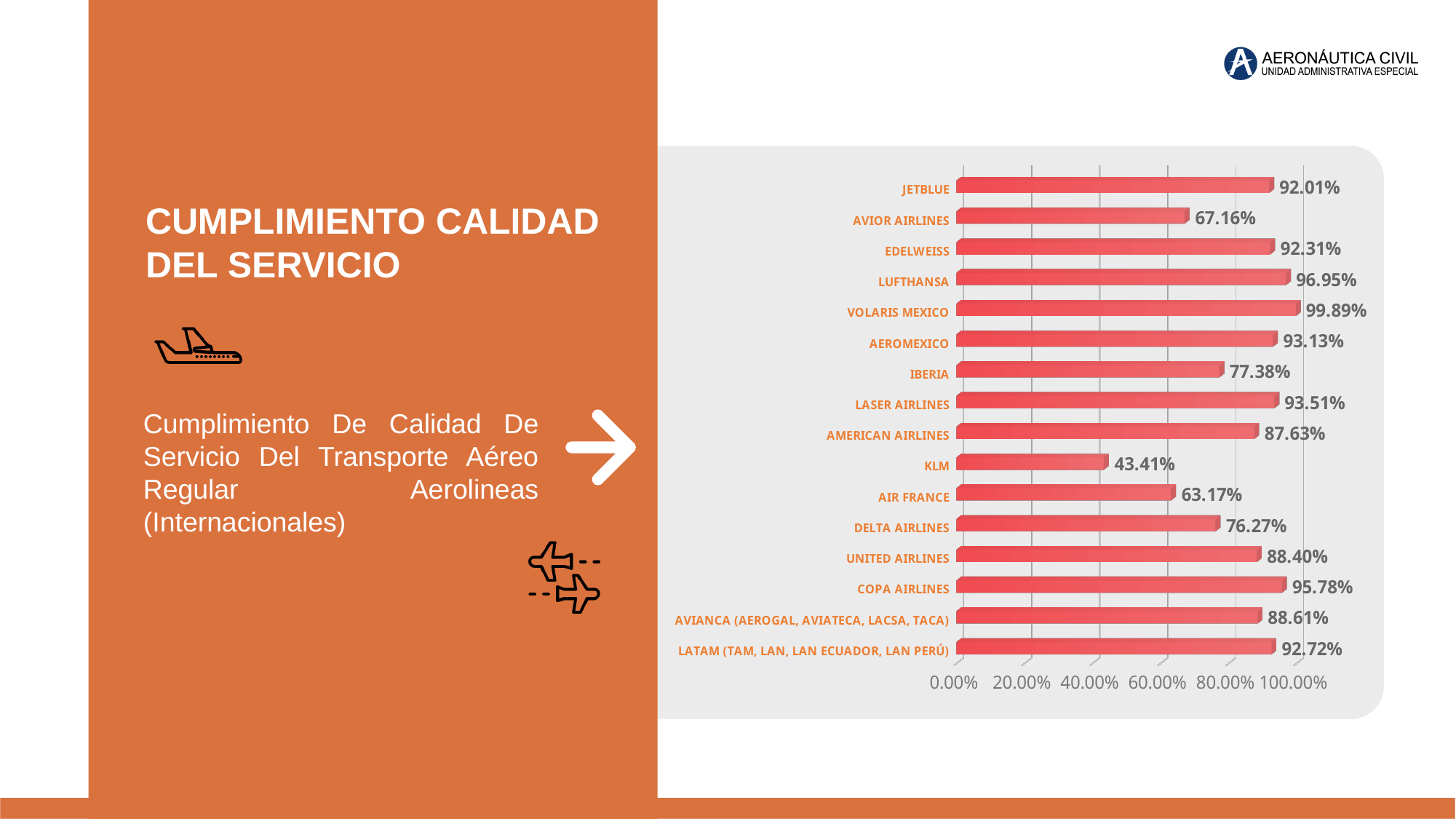
Which airline has the highest value? VOLARIS MEXICO Which has a larger value, AVIOR AIRLINES or AIR FRANCE? AVIOR AIRLINES What is the value for LATAM (TAM, LAN, LAN ECUADOR, LAN PERÚ)? 92.72% What is the value for AMERICAN AIRLINES? 87.63% What is the value for VOLARIS MEXICO? 99.89% How many airlines are shown in the chart? 16 What is the difference between the values for LUFTHANSA and IBERIA? 19.57 percentage points Which airline has the lowest value? KLM What is the difference between the values for COPA AIRLINES and KLM? 52.37 percentage points What kind of chart is shown on the slide? bar chart What is the value for KLM? 43.41% Is the value for KLM greater or less than 60.00%? less